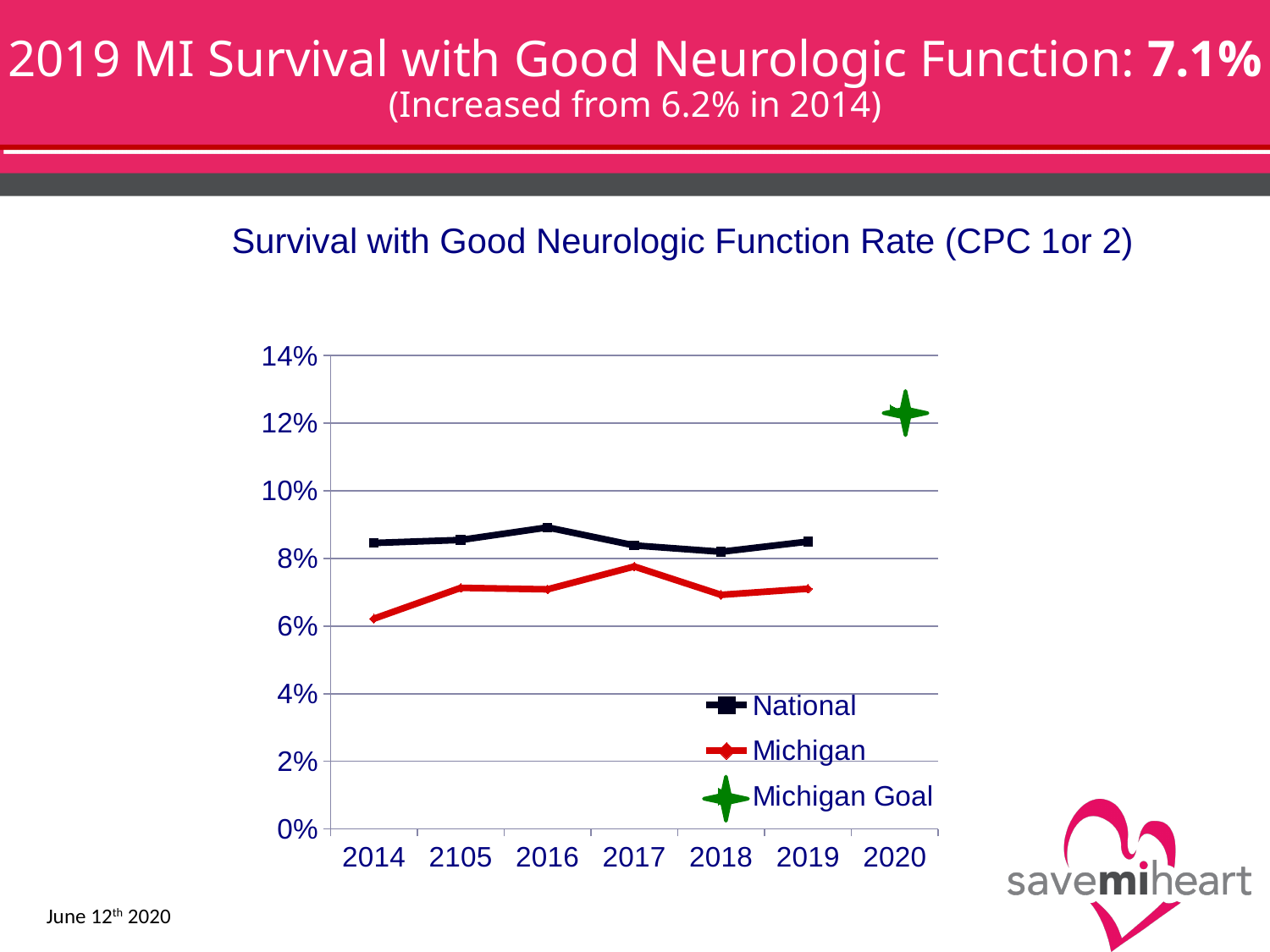
Is the Michigan Goal value for 2020 greater or less than 10%? greater What type of chart is shown on the slide? line chart By how many percentage points did the Michigan rate increase from 2014 to 2019? 0.9 percentage points What is the title of the chart? Survival with Good Neurologic Function Rate (CPC 1or 2) In 2019, which series has the higher value, National or Michigan? National Is the value for National in 2016 greater or less than 8%? greater What was the Michigan survival with good neurologic function rate in 2014? 6.2% How many series does the chart legend list? 3 How many year labels are shown along the x axis of the chart? 7 In which year is the National series at its highest? 2016 What is the Michigan survival with good neurologic function rate for 2019? 7.1% In which year is the Michigan series at its lowest? 2014